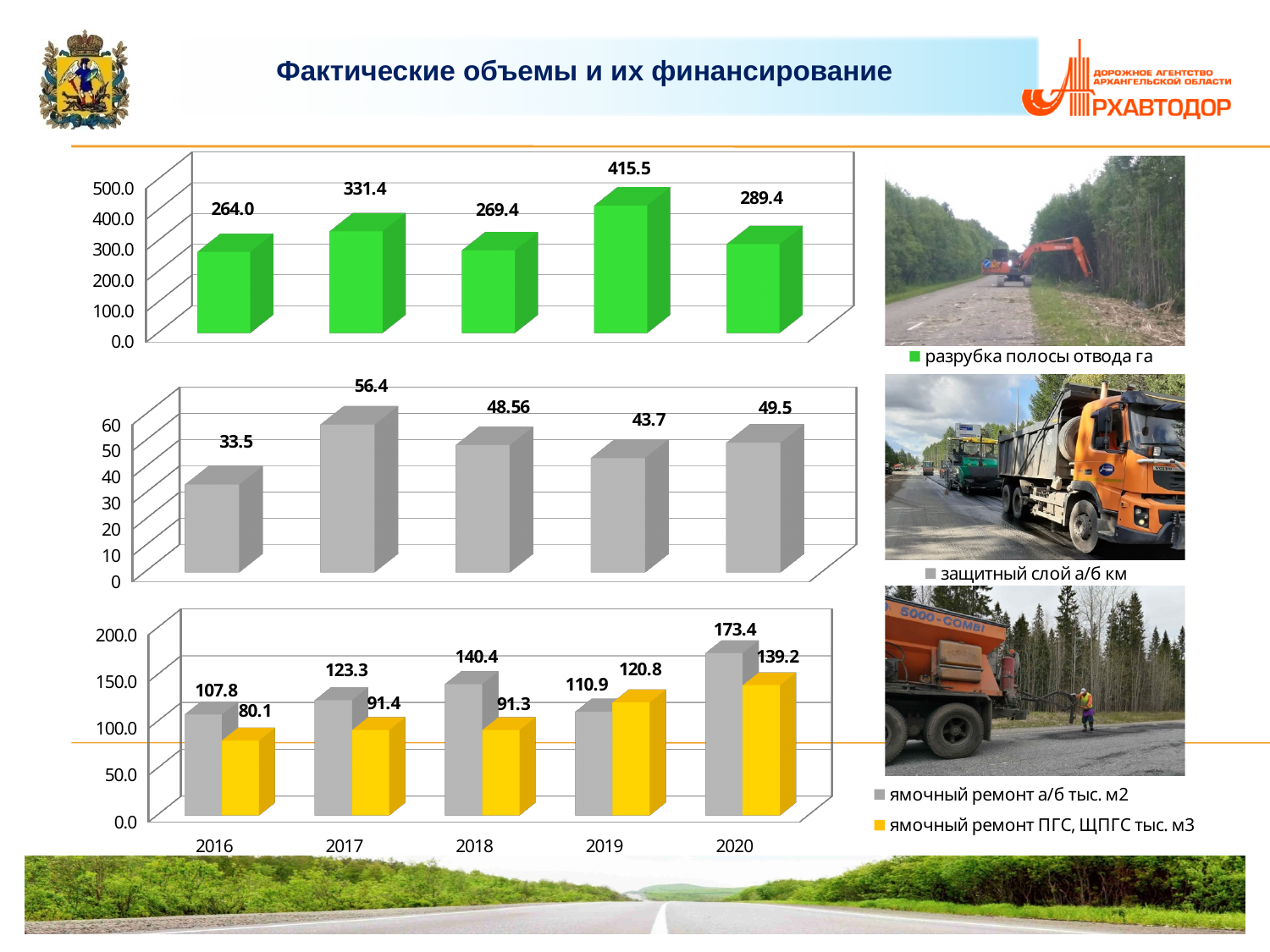
On the top chart (разрубка полосы отвода га), what is the value of the fourth bar? 415.5 On the middle chart (защитный слой а/б км), which bar is the highest? the second bar (56.4) On the top chart (разрубка полосы отвода га), which bar is the lowest? the first bar (264.0) On the middle chart (защитный слой а/б км), how many bars are plotted? 5 On the top chart (разрубка полосы отвода га), what is the difference between the fourth bar and the second bar? 84.1 On the bottom chart, what is the value for ямочный ремонт ПГС, ЩПГС тыс. м3 in 2019? 120.8 On the middle chart (защитный слой а/б км), what is the value of the third bar? 48.56 On the bottom chart, what is the value for ямочный ремонт а/б тыс. м2 in 2020? 173.4 What type of chart is the top chart (разрубка полосы отвода га)? bar chart On the bottom chart, which is larger in 2019: ямочный ремонт а/б тыс. м2 or ямочный ремонт ПГС, ЩПГС тыс. м3? ямочный ремонт ПГС, ЩПГС тыс. м3 On the bottom chart, what is the difference between ямочный ремонт а/б тыс. м2 and ямочный ремонт ПГС, ЩПГС тыс. м3 in 2016? 27.7 On the bottom chart, how many series does the legend list? 2